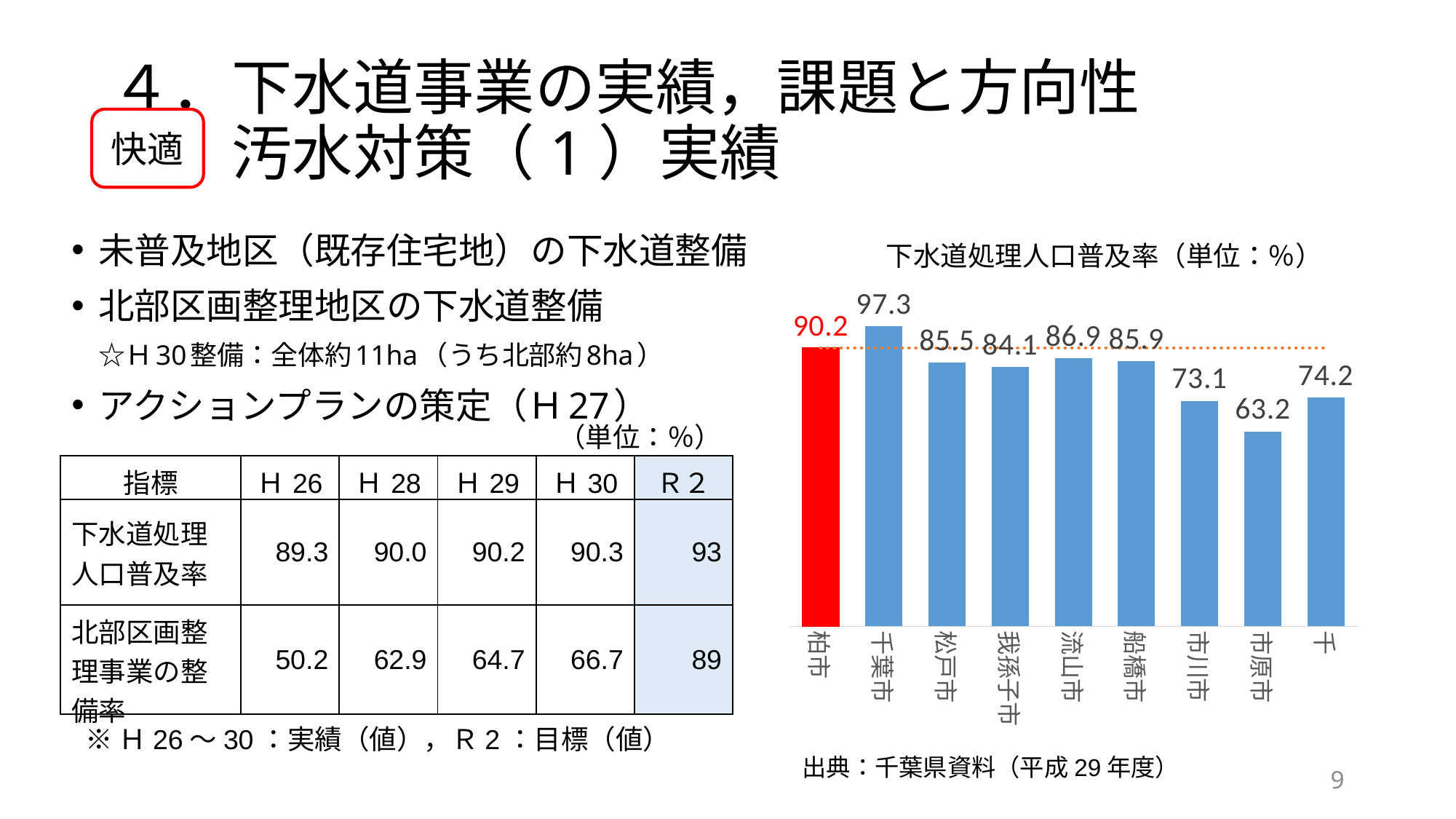
What is the difference between the values for 柏市 and 市川市 in the 下水道処理人口普及率 chart? 17.1 What is the value for 市原市 in the 下水道処理人口普及率 chart? 63.2 What kind of chart is the 下水道処理人口普及率 chart? bar chart Which bar in the 下水道処理人口普及率 chart is coloured red? 柏市 What is the value for 柏市 in the 下水道処理人口普及率 chart? 90.2 Which city has the highest value in the 下水道処理人口普及率 chart? 千葉市 In the 下水道処理人口普及率 chart, which is larger, the value for 松戸市 or the value for 我孫子市? 松戸市 What is the difference between the values for 千葉市 and 柏市 in the 下水道処理人口普及率 chart? 7.1 What is the value for 千葉市 in the 下水道処理人口普及率 chart? 97.3 What is the value for 流山市 in the 下水道処理人口普及率 chart? 86.9 How many bars are plotted in the 下水道処理人口普及率 chart? 9 Which city has the lowest value in the 下水道処理人口普及率 chart? 市原市